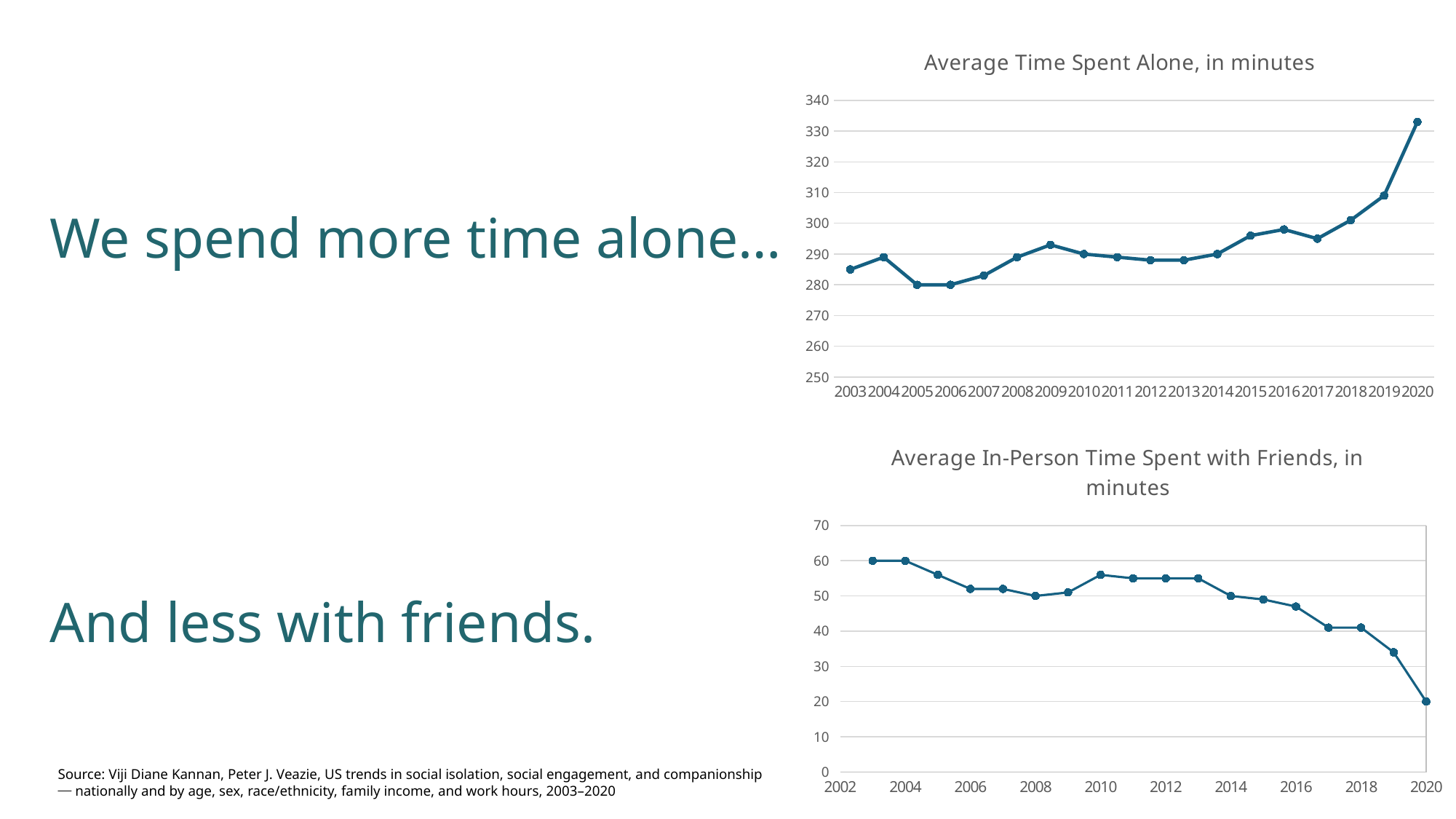
What is the title of the bottom chart on the slide? Average In-Person Time Spent with Friends, in minutes In the 'Average Time Spent Alone, in minutes' chart, how many years are plotted? 18 In the 'Average In-Person Time Spent with Friends, in minutes' chart, which year has the lowest value? 2020 In the 'Average Time Spent Alone, in minutes' chart, is the value for 2020 greater or less than 320? greater In the 'Average In-Person Time Spent with Friends, in minutes' chart, do the values generally rise or fall from 2003 to 2020? fall In the 'Average Time Spent Alone, in minutes' chart, which is larger, the value for 2019 or the value for 2009? 2019 In the 'Average Time Spent Alone, in minutes' chart, which year has the highest value? 2020 In the 'Average In-Person Time Spent with Friends, in minutes' chart, what is the value for 2003? 60 What type of chart is the 'Average Time Spent Alone, in minutes' chart? line chart In the 'Average In-Person Time Spent with Friends, in minutes' chart, what is the value for 2020? 20 In the 'Average Time Spent Alone, in minutes' chart, is the value for 2005 greater or less than 290? less In the 'Average In-Person Time Spent with Friends, in minutes' chart, is the value for 2019 greater or less than 30? greater